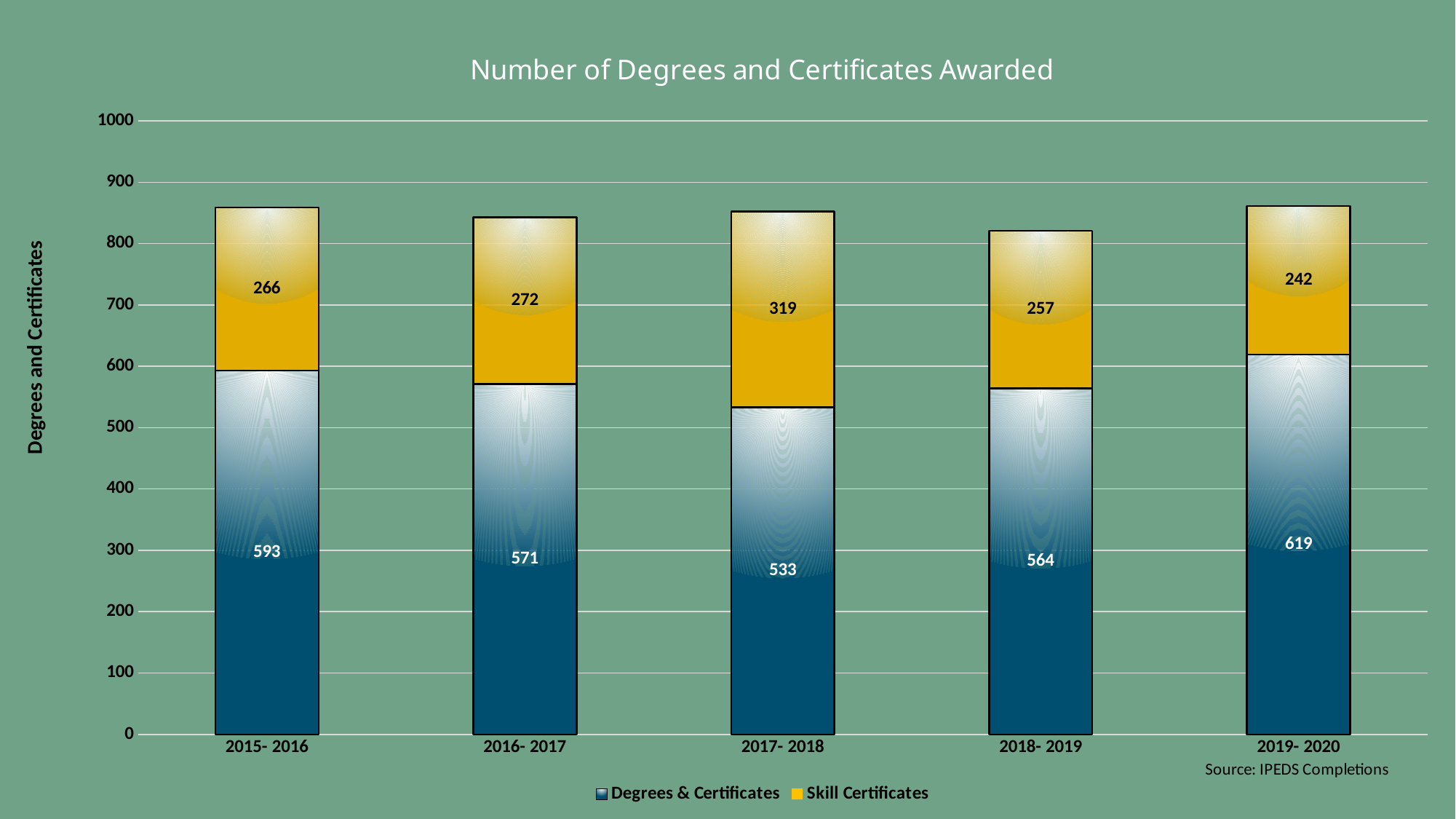
What kind of chart is shown? Stacked bar chart Which year has the highest value for Skill Certificates? 2017- 2018 What is the total of the stacked bar for 2017- 2018? 852 How many years are shown on the x axis? 5 What is the value for Skill Certificates in 2017- 2018? 319 Which year has the lowest value for Degrees & Certificates? 2017- 2018 How many series does the legend list? 2 What is the total of the stacked bar for 2015- 2016? 859 What is the difference between Degrees & Certificates in 2019- 2020 and 2018- 2019? 55 What is the value for Degrees & Certificates in 2016- 2017? 571 What is the value for Degrees & Certificates in 2019- 2020? 619 Which is larger: Skill Certificates in 2015- 2016 or in 2019- 2020? 2015- 2016